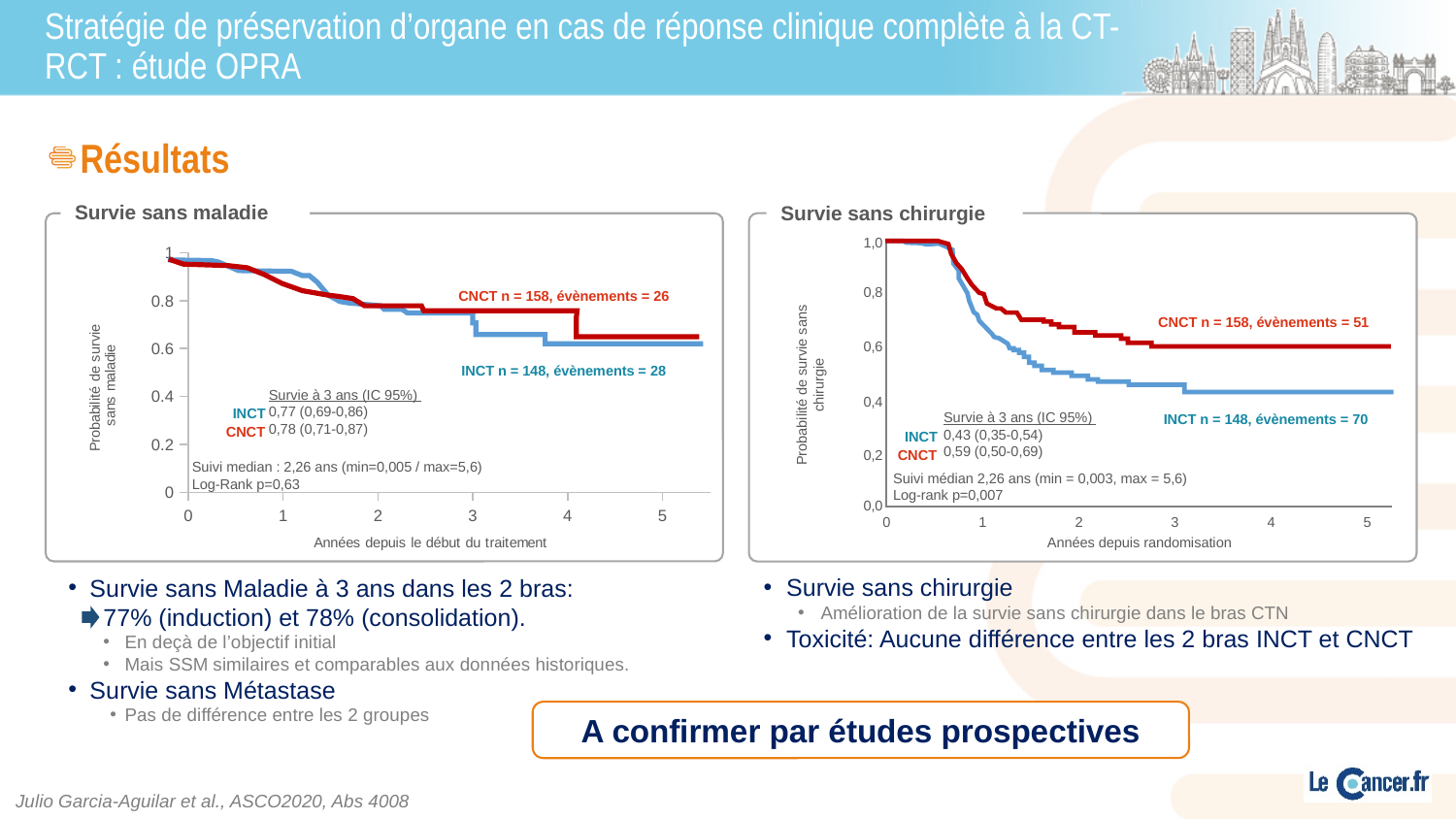
In the 'Survie sans chirurgie' chart, how many events are reported for the INCT arm? 70 In the 'Survie sans maladie' chart, how many events are reported for the CNCT arm? 26 In the 'Survie sans maladie' chart, what is the 3-year survival for CNCT? 0,78 (0,71-0,87) In the 'Survie sans chirurgie' chart, what is the 3-year survival for INCT? 0,43 (0,35-0,54) In the 'Survie sans chirurgie' chart, is the INCT curve at 4 years greater or less than 0,6? less In the 'Survie sans chirurgie' chart, what is the 3-year survival for CNCT? 0,59 (0,50-0,69) In the 'Survie sans maladie' chart, what is the 3-year survival for INCT? 0,77 (0,69-0,86) What is the log-rank p-value shown in the 'Survie sans chirurgie' chart? p=0,007 In the 'Survie sans chirurgie' chart, which arm has the higher 3-year survival, INCT or CNCT? CNCT How many series (arms) are plotted in the 'Survie sans chirurgie' chart? 2 In the 'Survie sans maladie' chart, do the curves rise or fall as the years since start of treatment increase? fall In the 'Survie sans chirurgie' chart, what is the difference in the number of events between INCT and CNCT? 19